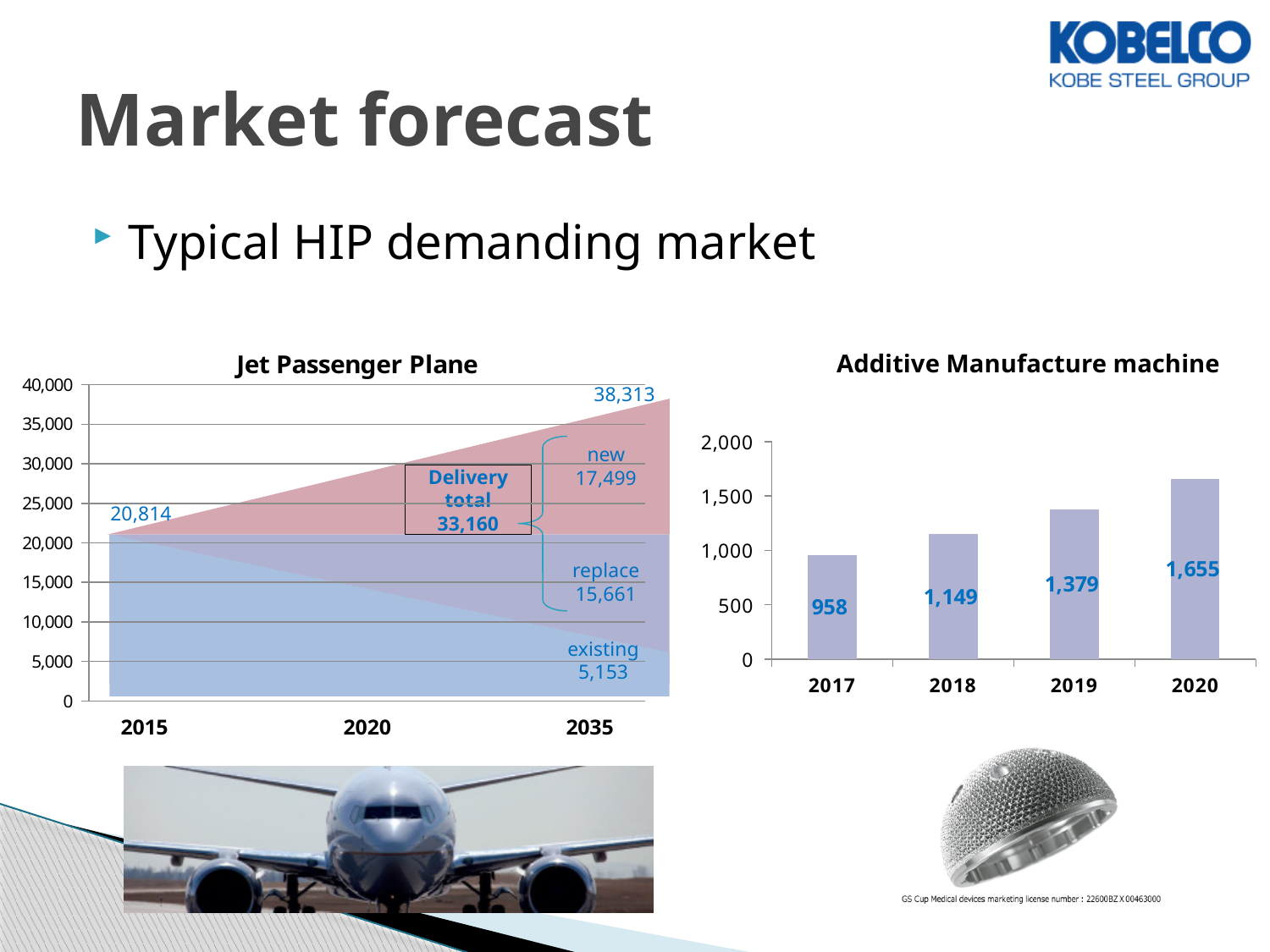
In the Jet Passenger Plane chart, what is the value shown for 2035? 38,313 In the Jet Passenger Plane chart, what is the value labelled 'replace'? 15,661 In the Jet Passenger Plane chart, what is the Delivery total shown? 33,160 What kind of chart is the Additive Manufacture machine chart? bar chart In the Jet Passenger Plane chart, what is the value shown for 2015? 20,814 How many bars are shown in the Additive Manufacture machine chart? 4 In the Additive Manufacture machine chart, what is the value for 2019? 1,379 In the Additive Manufacture machine chart, do the values rise or fall from 2017 to 2020? rise In the Additive Manufacture machine chart, which year has the lowest value? 2017 In the Additive Manufacture machine chart, which year has the highest value? 2020 In the Additive Manufacture machine chart, which is larger, the value for 2018 or the value for 2019? 2019 In the Additive Manufacture machine chart, what is the difference between the 2020 and 2017 values? 697